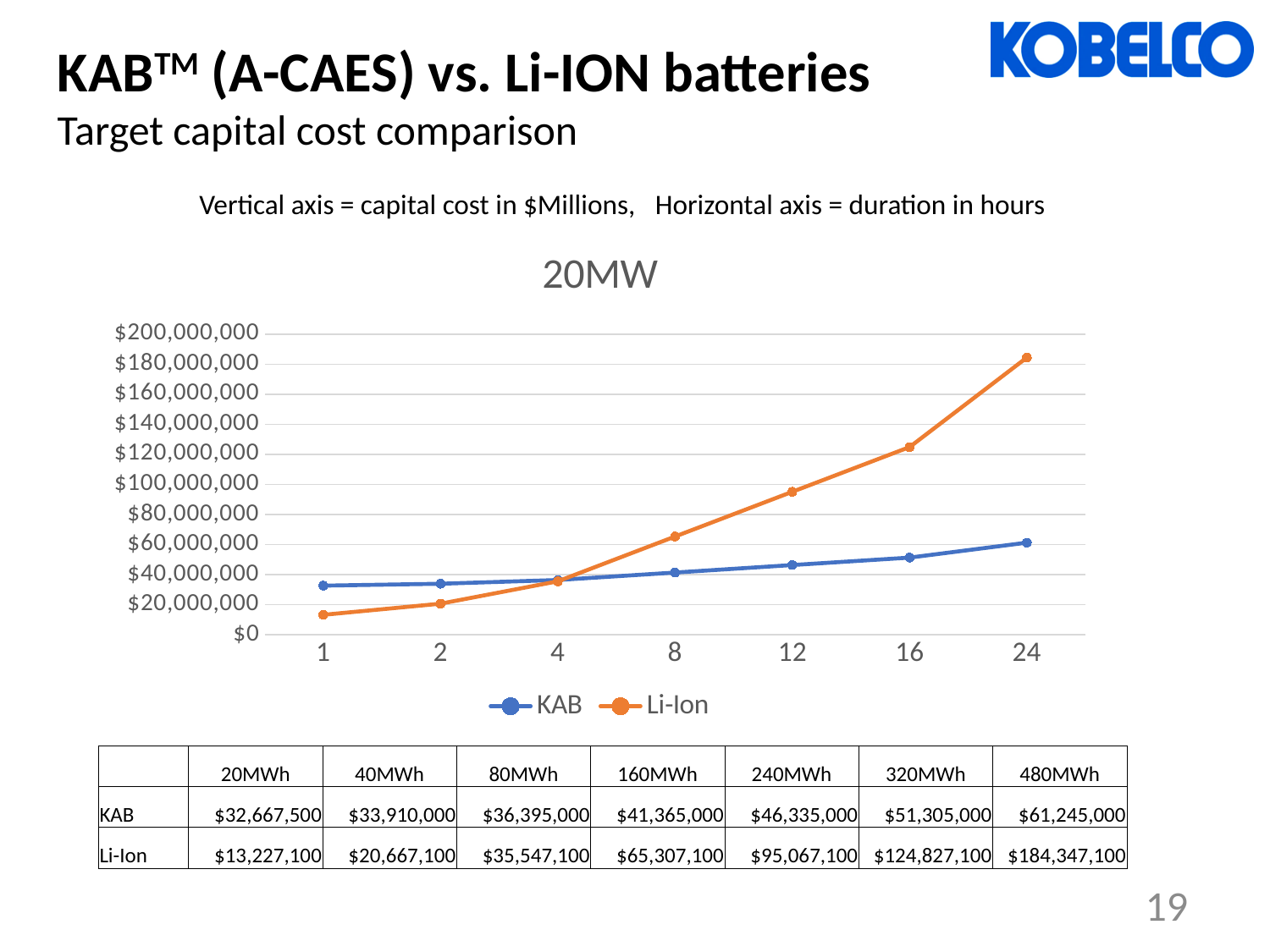
According to the table, what is the Li-Ion capital cost at 20MWh (1 hour)? $13,227,100 According to the table, what is the KAB capital cost at 480MWh (24 hours)? $61,245,000 What type of chart is shown on the slide? line chart What is the difference between the Li-Ion and KAB capital costs at 480MWh (24 hours)? $123,102,100 How many series does the chart legend list? 2 What is the title of the chart? 20MW Which series has the lower capital cost at 1 hour, KAB or Li-Ion? Li-Ion How many duration points are plotted along the horizontal axis of the chart? 7 According to the table, what is the Li-Ion capital cost at 160MWh (8 hours)? $65,307,100 Is the Li-Ion value at 16 hours greater or less than $100,000,000? greater Which series has the higher capital cost at 24 hours, KAB or Li-Ion? Li-Ion Does the KAB capital cost rise or fall as duration increases along the horizontal axis? rise